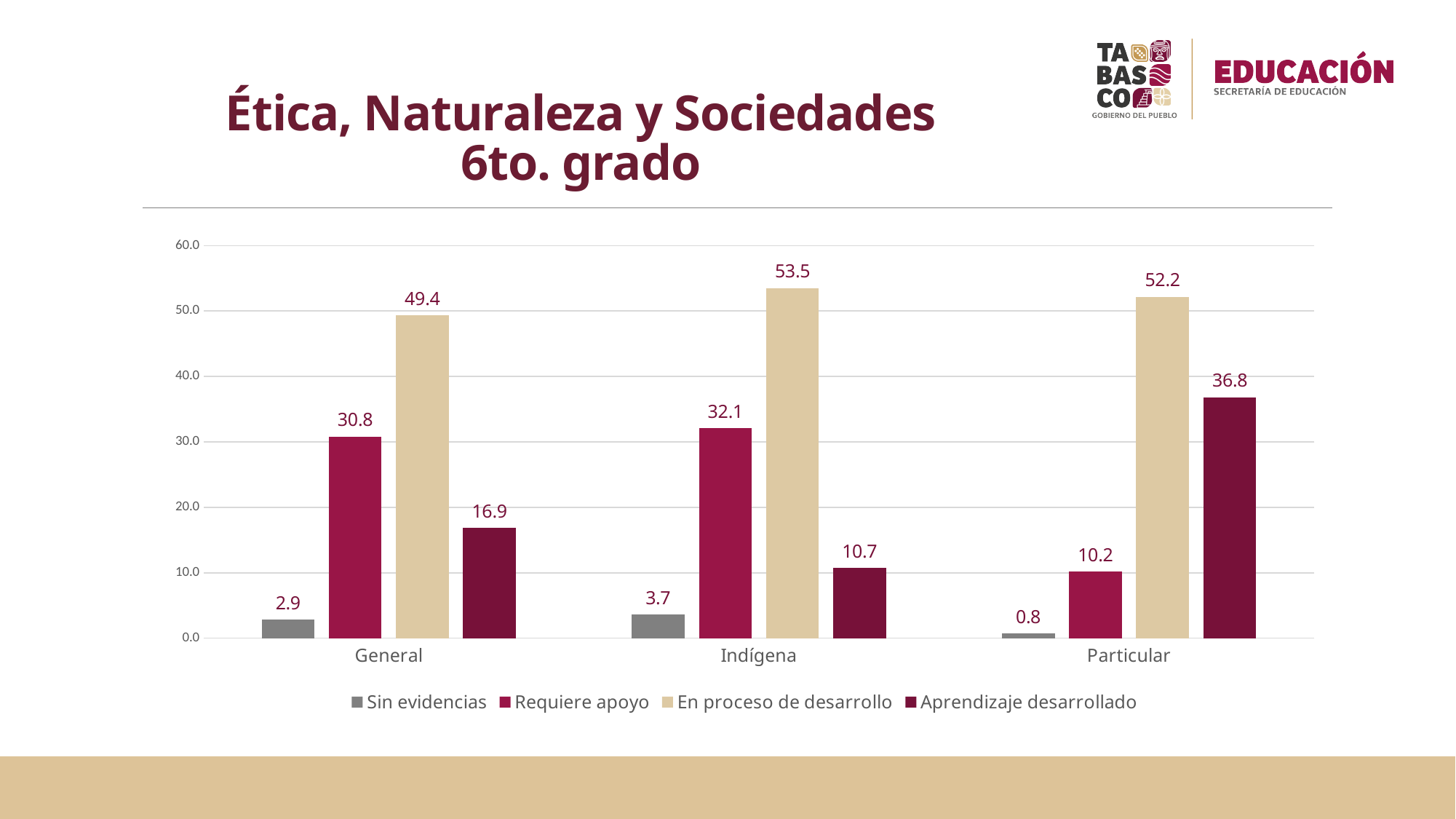
What is the value for "Aprendizaje desarrollado" in the General category? 16.9 Which is larger: "Requiere apoyo" for General or "Requiere apoyo" for Indígena? Indígena What is the value for "Sin evidencias" in the Particular category? 0.8 Which category has the lowest value for "Requiere apoyo"? Particular What is the title of the slide? Ética, Naturaleza y Sociedades 6to. grado Is the value for "Aprendizaje desarrollado" in the Particular category greater or less than 30.0? greater How many categories are shown on the x axis? 3 What kind of chart is shown on the slide? bar chart How many series does the legend list? 4 What is the value for "En proceso de desarrollo" in the Indígena category? 53.5 Which category has the highest value for "Aprendizaje desarrollado"? Particular What is the difference between "En proceso de desarrollo" and "Requiere apoyo" in the General category? 18.6